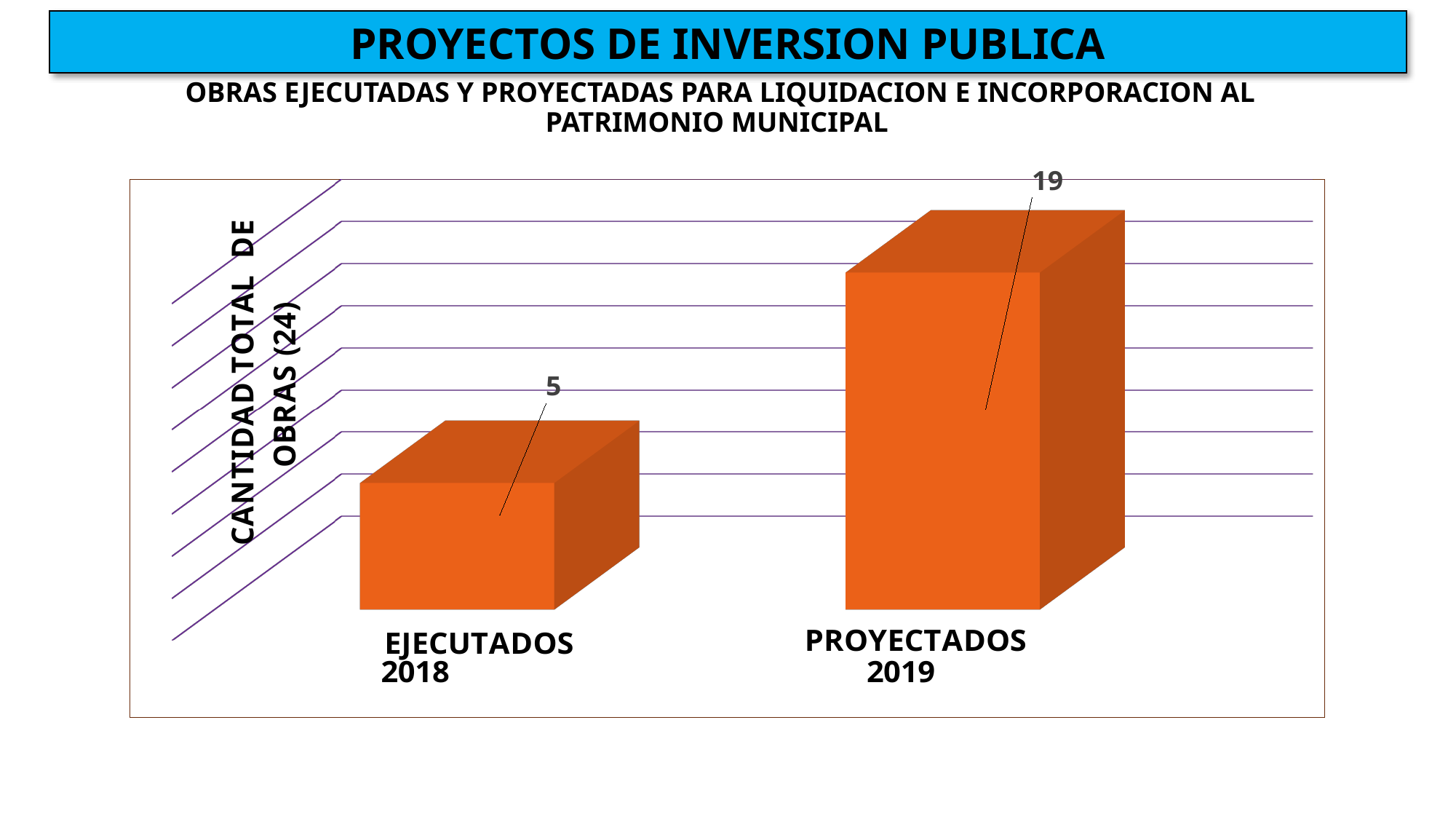
What is the value for PROYECTADOS 2019? 19 What colour are the bars in the chart? orange What is the value for EJECUTADOS 2018? 5 Which is larger, the value for EJECUTADOS 2018 or the value for PROYECTADOS 2019? PROYECTADOS 2019 Which category has the lowest value? EJECUTADOS 2018 How many categories are shown in the chart? 2 Which category has the highest value? PROYECTADOS 2019 What is the total of the two values shown in the chart? 24 What is the difference between the values for PROYECTADOS 2019 and EJECUTADOS 2018? 14 What kind of chart is shown on the slide? bar chart Do the values rise or fall from EJECUTADOS 2018 to PROYECTADOS 2019? rise What is the label on the vertical axis of the chart? CANTIDAD TOTAL DE OBRAS (24)